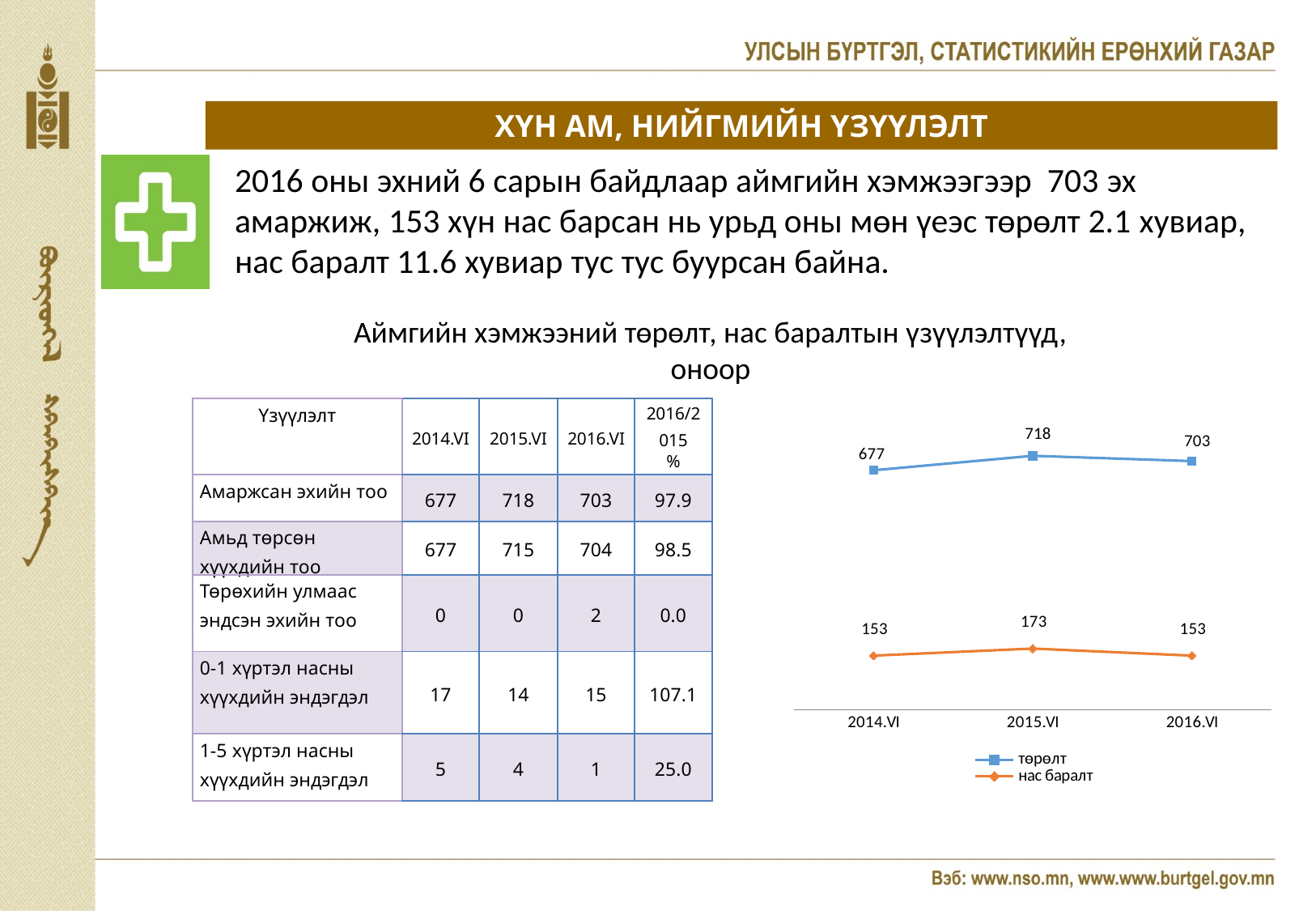
What is the difference between төрөлт in 2015.VI and 2016.VI? 15 Which series is drawn in orange in the chart? нас баралт What is the value of төрөлт for 2014.VI? 677 In which period is төрөлт highest? 2015.VI What is the value of төрөлт for 2015.VI? 718 What kind of chart is shown on the slide? line chart How many points are plotted along the x axis for each series? 3 What is the difference between нас баралт in 2015.VI and 2014.VI? 20 In which period is төрөлт lowest? 2014.VI Which is larger: төрөлт in 2016.VI or төрөлт in 2014.VI? 2016.VI How many series does the chart legend list? 2 What is the value of нас баралт for 2016.VI? 153